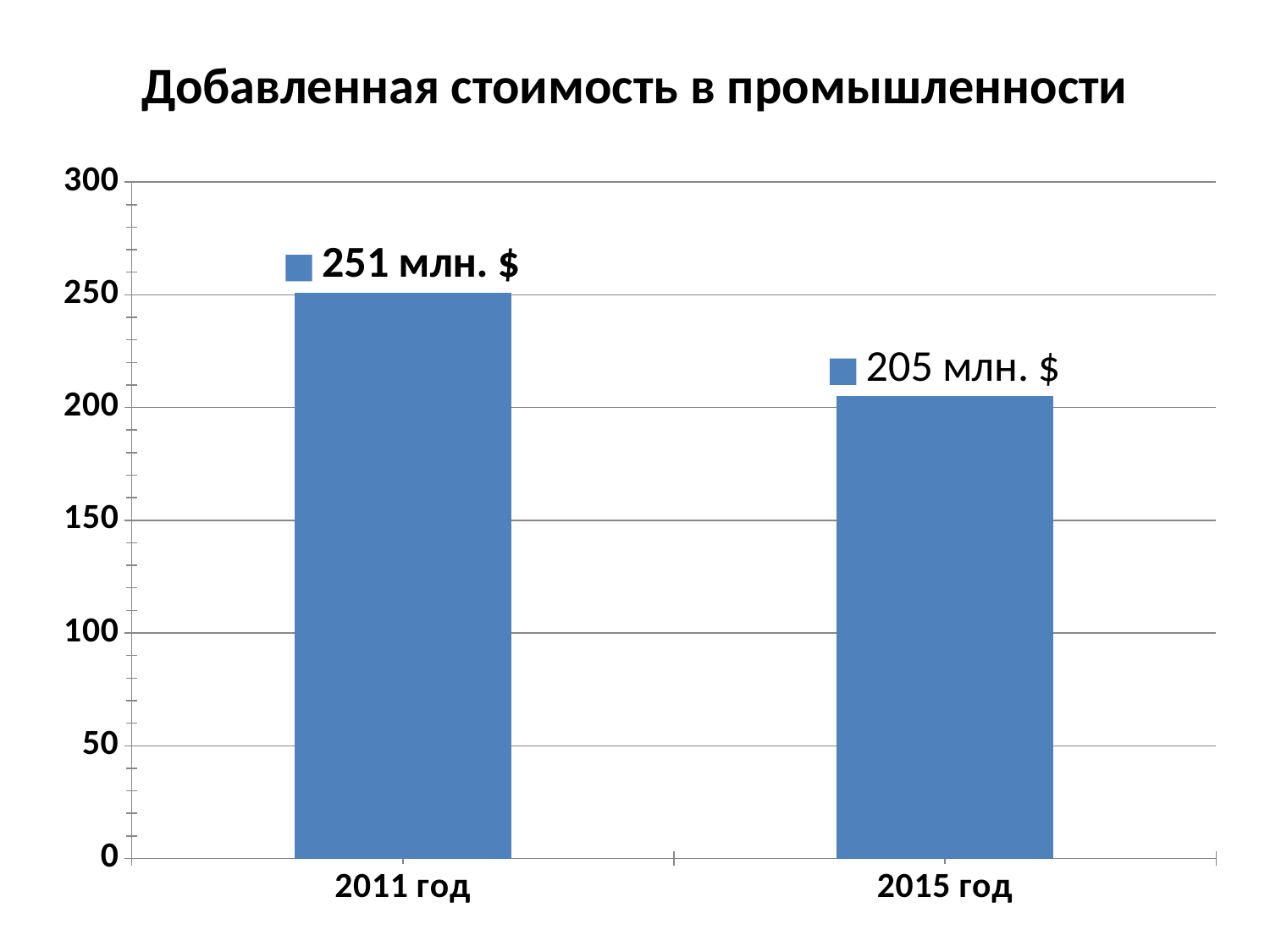
How many categories are shown on the x axis? 2 What is the title of the chart? Добавленная стоимость в промышленности What is the value for 2015 год? 205 млн. $ Which is larger, the value for 2011 год or for 2015 год? 2011 год Do the values rise or fall from 2011 год to 2015 год? fall Which year has the lowest value? 2015 год What is the difference between the values for 2011 год and 2015 год? 46 млн. $ What kind of chart is this? bar chart Is the value for 2011 год greater or less than 200? greater Is the value for 2015 год greater or less than 250? less Which year has the highest value? 2011 год What is the value for 2011 год? 251 млн. $